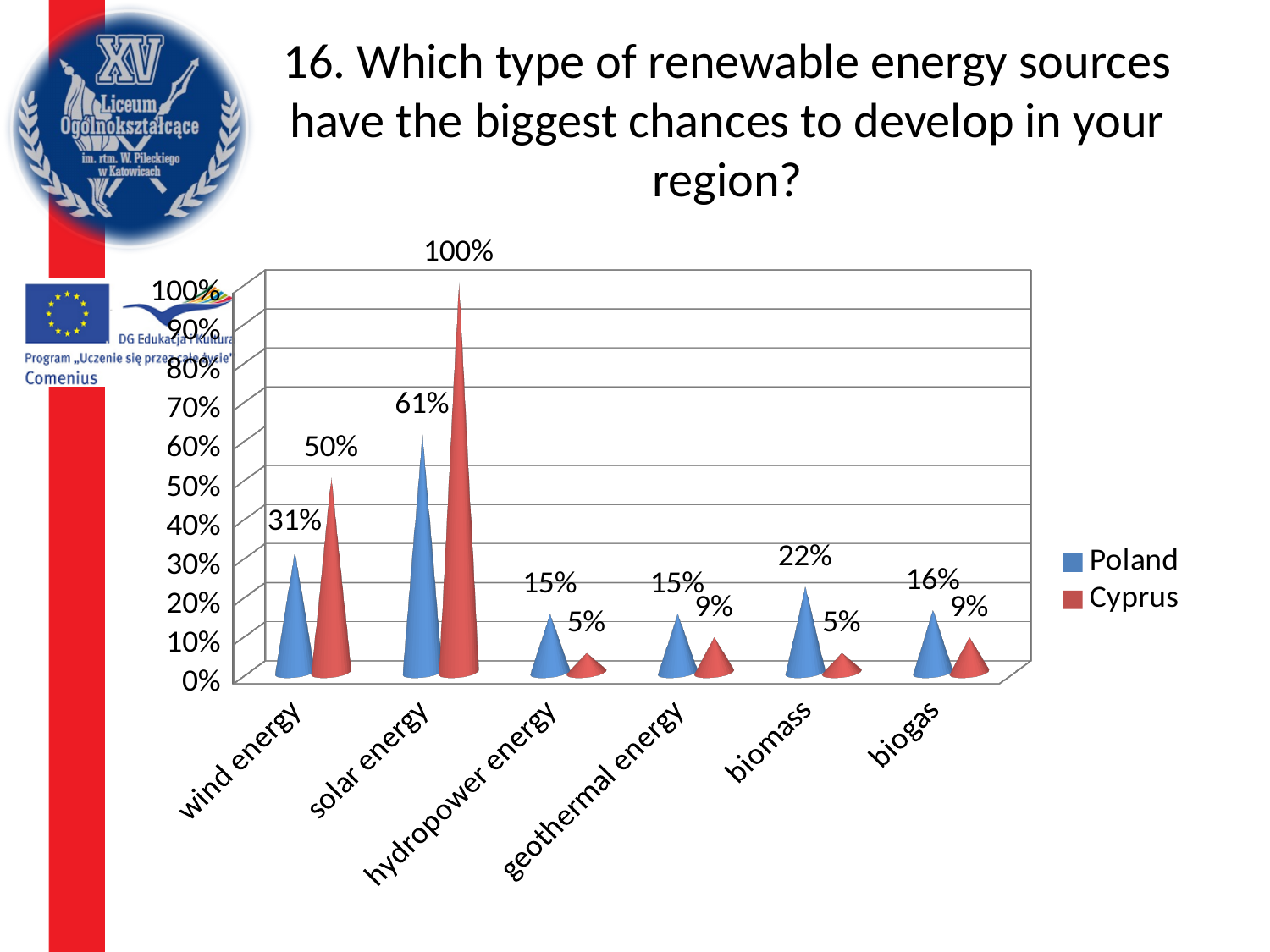
What is the value for Poland for biogas? 16% What is the value for Cyprus for wind energy? 50% What is the value for Cyprus for biomass? 5% Which is larger for biomass, the value for Poland or for Cyprus? Poland How many categories are shown on the x axis? 6 What is the value for Poland for solar energy? 61% What is the difference between the Cyprus and Poland values for solar energy? 39% How many series does the legend list? 2 Which colour represents Cyprus in the chart? red What kind of chart is shown on the slide? bar chart Which category has the lowest value for Poland? hydropower energy and geothermal energy (15%) Which category has the highest value for Cyprus? solar energy